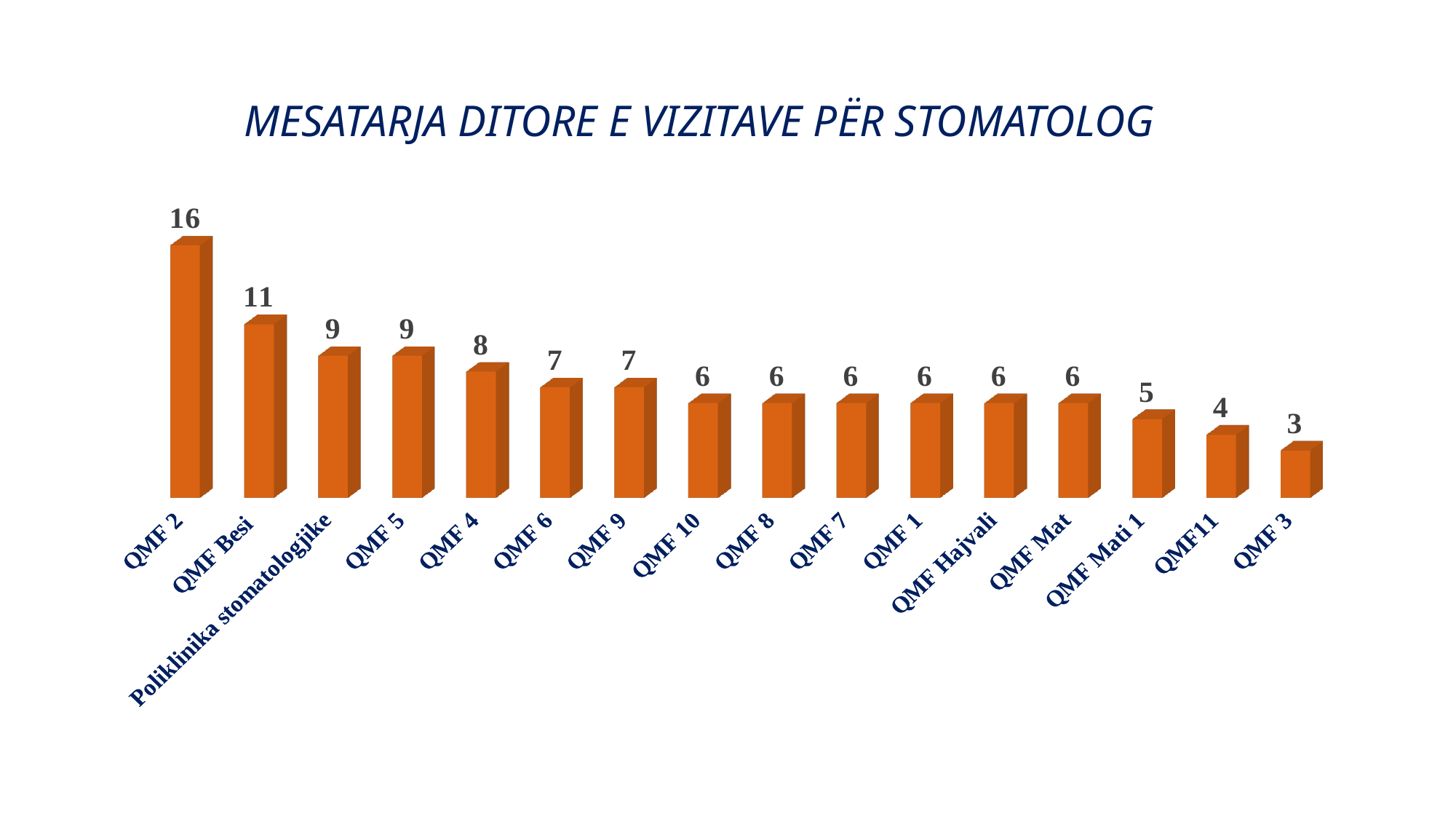
What is the value for QMF 2? 16 How many categories are shown in the chart? 16 What is the difference between the values for QMF 2 and QMF Besi? 5 What is the value for QMF Mati 1? 5 Which is larger, the value for QMF 4 or the value for QMF11? QMF 4 Which category has the lowest value? QMF 3 What is the value for QMF Besi? 11 Which category has the highest value? QMF 2 What is the title of the chart? MESATARJA DITORE E VIZITAVE PËR STOMATOLOG Do the values rise or fall from left to right along the x axis? Fall What kind of chart is shown on the slide? Bar chart What is the value for Poliklinika stomatologjike? 9